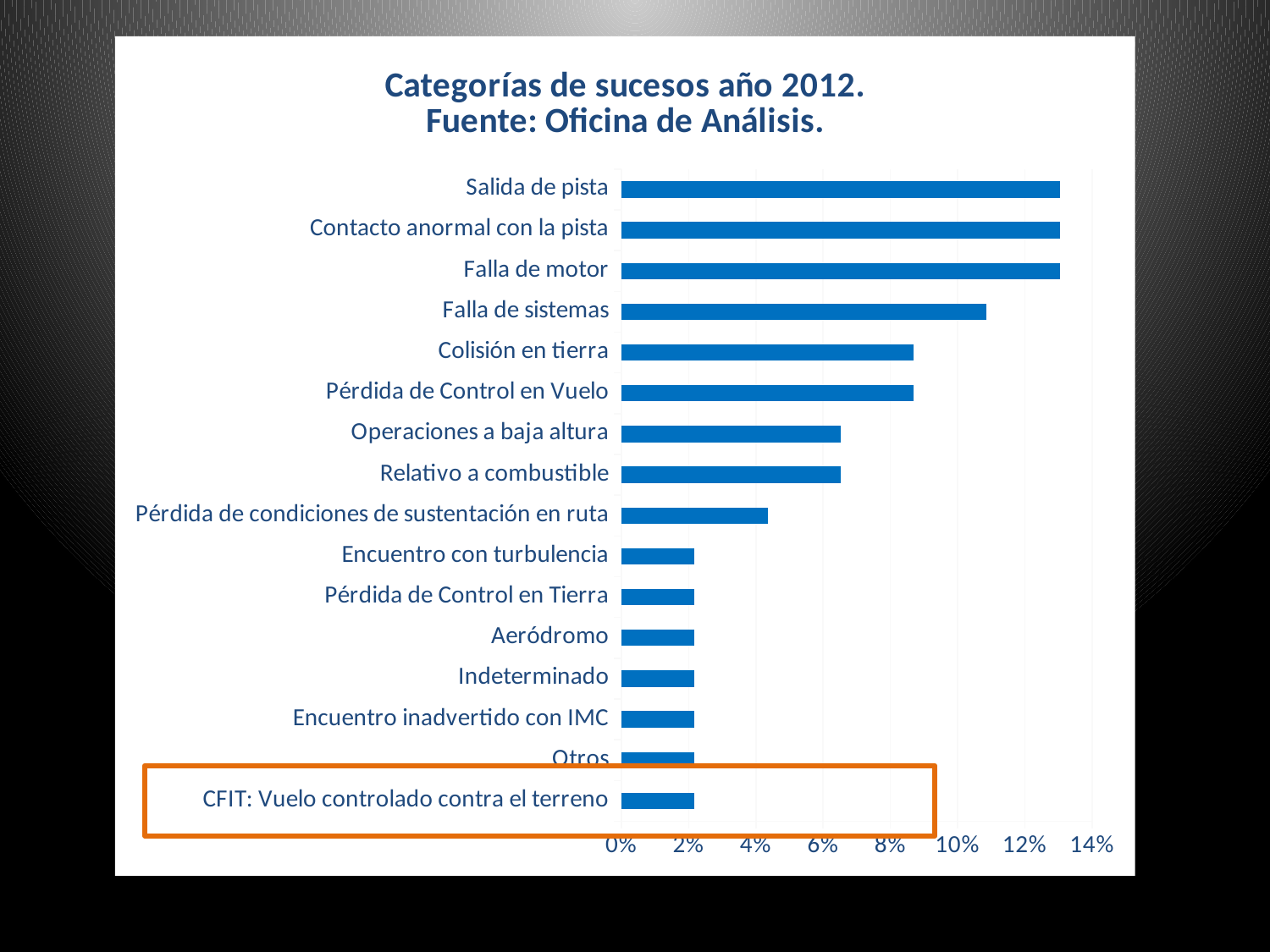
Which category is highlighted with an orange box on the slide? CFIT: Vuelo controlado contra el terreno Is the value for Encuentro con turbulencia greater or less than 4%? less Is the value for Falla de sistemas greater or less than 10%? greater What kind of chart is shown on the slide? bar chart Is the value for Colisión en tierra greater or less than 10%? less Which has the larger value, Relativo a combustible or Aeródromo? Relativo a combustible How many categories are plotted in the chart? 16 What is the title of the chart? Categorías de sucesos año 2012. Fuente: Oficina de Análisis. Which has the larger value, Falla de sistemas or Colisión en tierra? Falla de sistemas